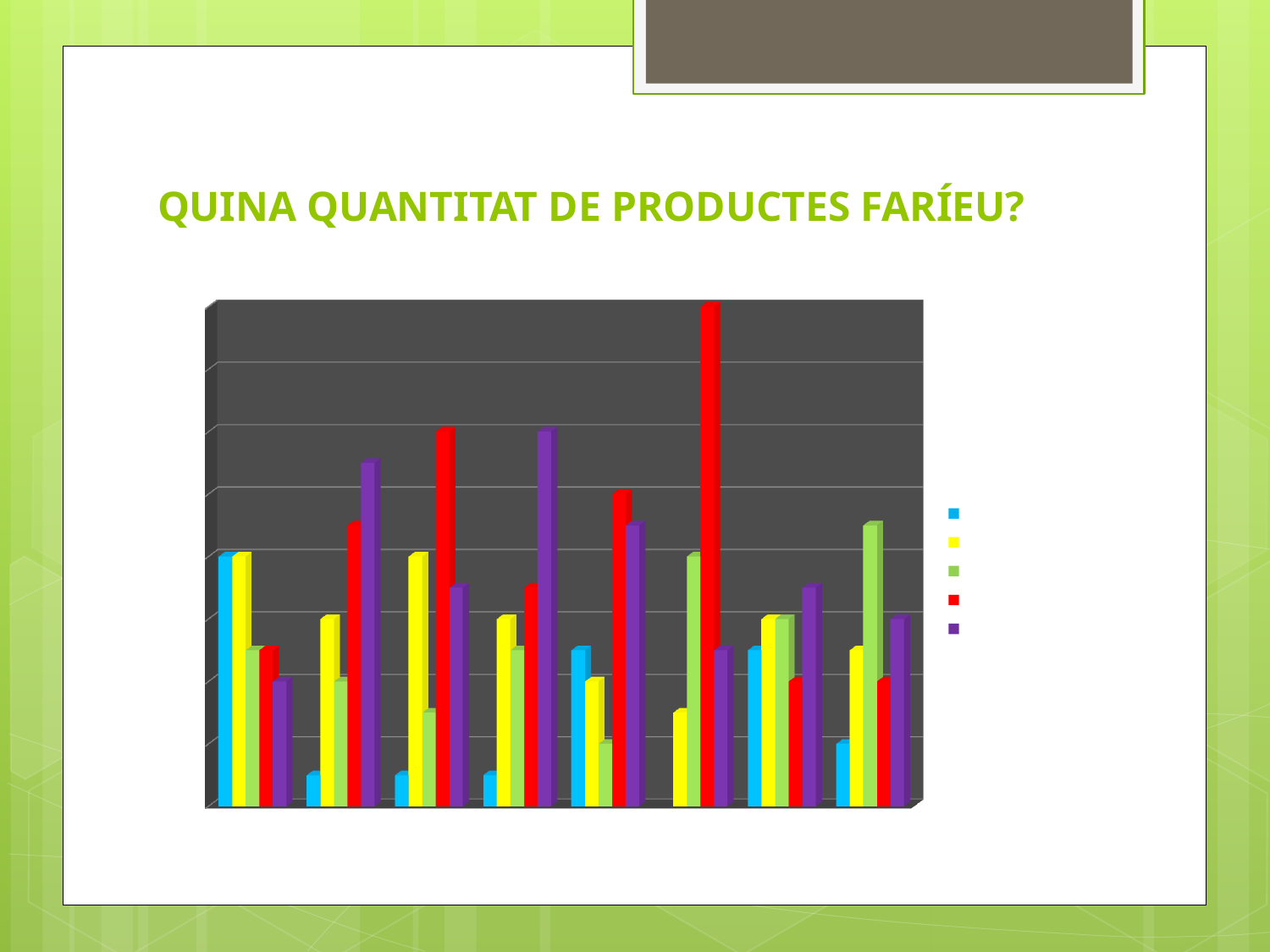
Which colour is the tallest bar on the whole chart? red How many groups of bars are plotted along the x axis? 8 In which group from the left does the tallest bar on the chart appear? the sixth What colours are the five legend markers, from top to bottom? blue, yellow, green, red, purple What is the title shown above the chart? QUINA QUANTITAT DE PRODUCTES FARÍEU? In the fourth group of bars from the left, which is taller, the red bar or the green bar? the red bar In the first group of bars from the left, which colour bar is the shortest? purple How many series does the legend list? 5 In the last group of bars on the right, which colour bar is the tallest? green In the seventh group of bars from the left, which is taller, the red bar or the purple bar? the purple bar What kind of chart is shown on the slide? bar chart In the second group of bars from the left, which colour bar is the shortest? blue